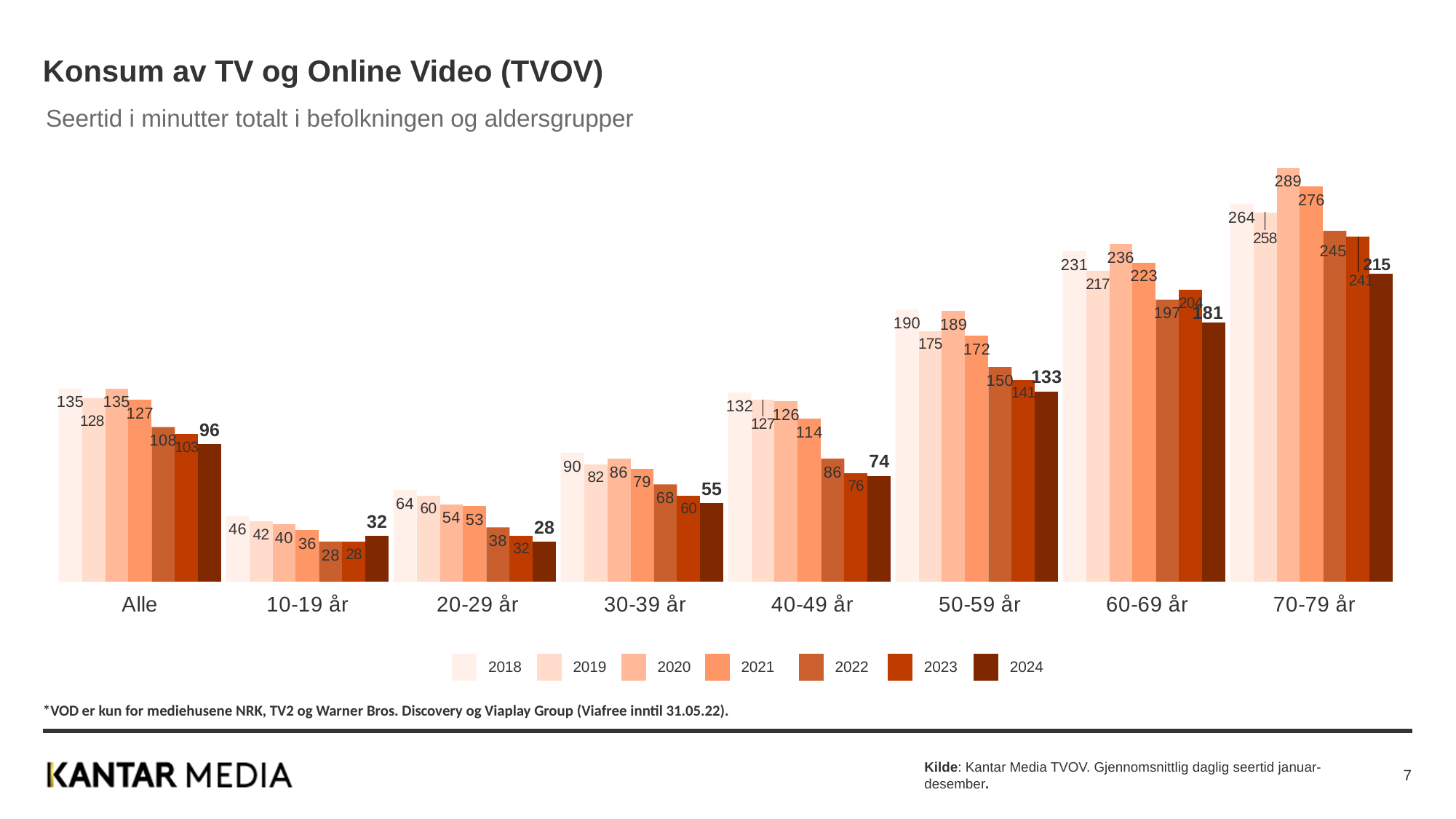
Which category has the lowest value for 2024? 20-29 år What is the difference between the 2020 and 2024 values for '70-79 år'? 74 What is the value for 2018 in the '70-79 år' category? 264 Which age group has the highest value for 2024? 70-79 år What kind of chart is shown on the slide? bar chart For the '20-29 år' category, do the values rise or fall from 2018 to 2024? fall How many categories are shown on the x axis? 8 How many series does the legend list? 7 What is the value for 2022 in the '40-49 år' category? 86 What is the value for 2024 in the 'Alle' category? 96 Which is larger for 2024: the value for '50-59 år' or for '60-69 år'? 60-69 år What is the title of the chart? Konsum av TV og Online Video (TVOV)